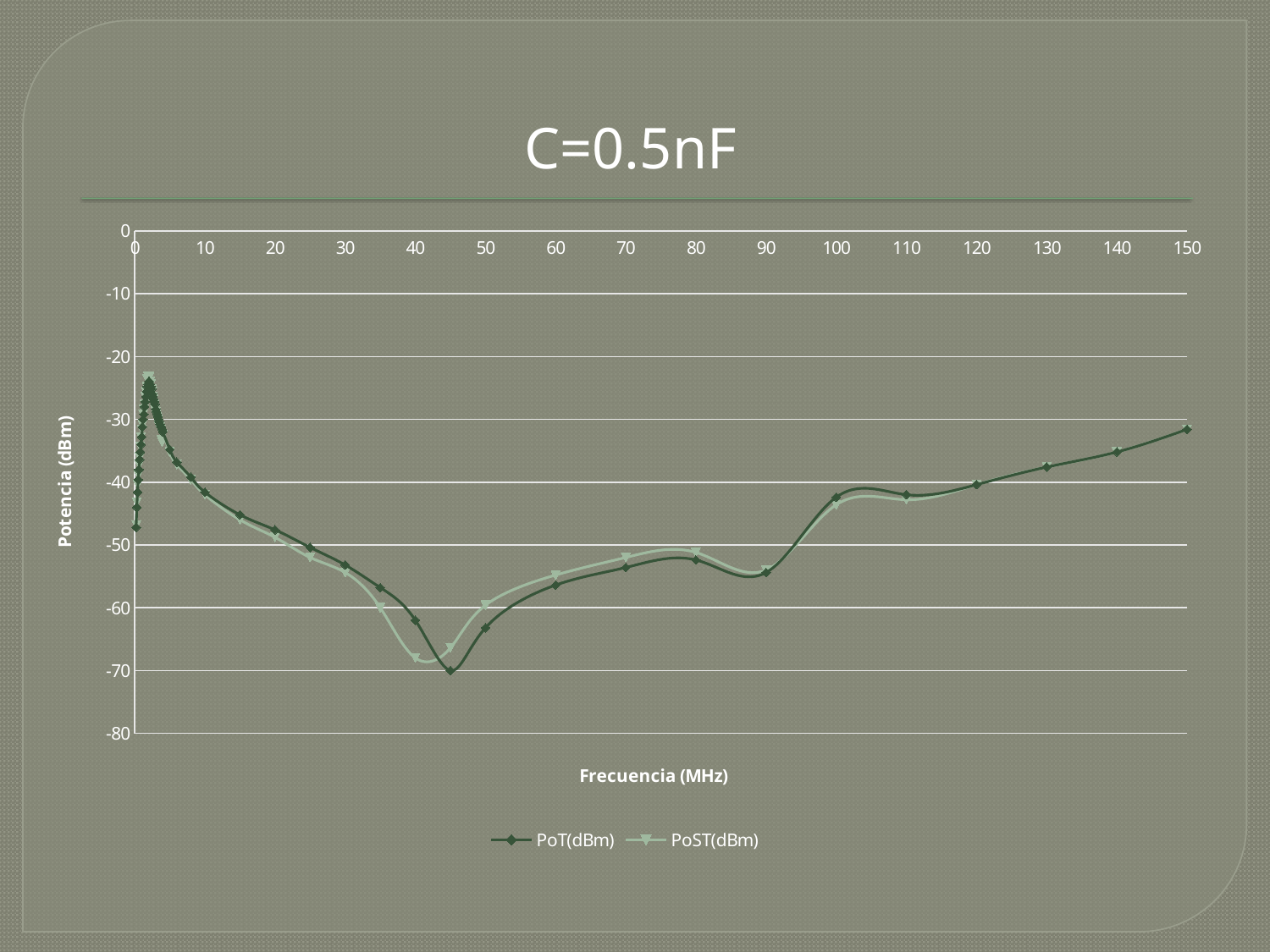
Is the PoT(dBm) value at 150 MHz greater or less than -40? greater Is the PoST(dBm) value at 40 MHz greater or less than -60? less At which frequency does the PoT(dBm) series reach its lowest value? 45 MHz Is the PoT(dBm) value at 45 MHz greater or less than -60? less What kind of chart is shown on the slide? line chart Between 100 MHz and 150 MHz, does the PoT(dBm) series rise or fall? rise Between 50 MHz and 80 MHz, does the PoT(dBm) series rise or fall? rise What is the title of the chart? C=0.5nF What are the two series named in the legend? PoT(dBm) and PoST(dBm) At 45 MHz, which series has the higher value, PoT(dBm) or PoST(dBm)? PoST(dBm) How many series does the legend list? 2